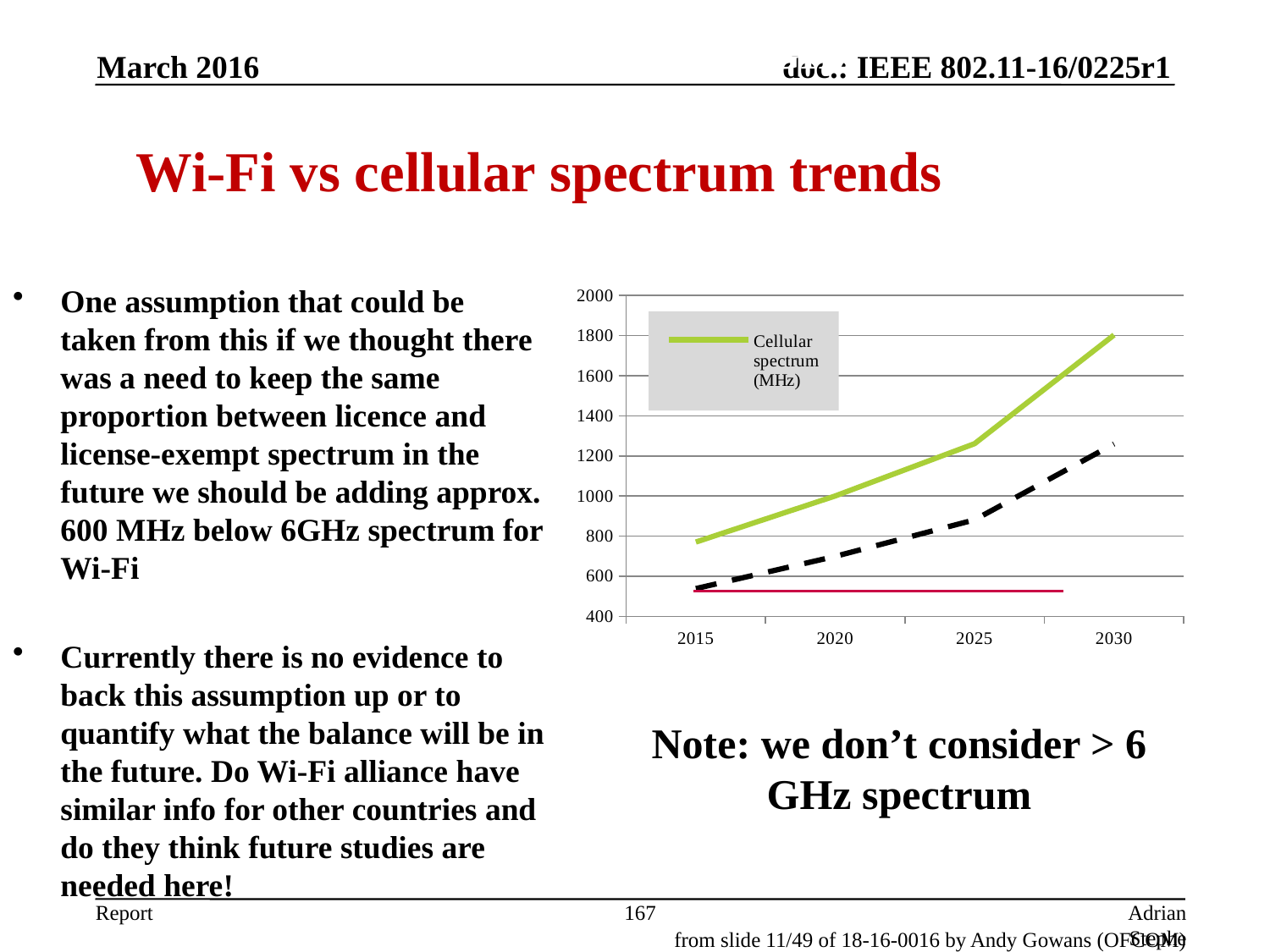
Is the Cellular spectrum (MHz) value for 2025 greater or less than 1200? greater What colour is the Cellular spectrum (MHz) line in the chart? green In 2025, which line is higher, the green Cellular spectrum line or the black dashed line? the green Cellular spectrum line What kind of chart is shown on the slide? line chart Is the Cellular spectrum (MHz) value for 2030 greater or less than 1600? greater Is the value of the black dashed line in 2015 greater or less than 600? less Which year has the higher Cellular spectrum (MHz) value, 2015 or 2030? 2030 How many years are marked on the x axis of the chart? 4 What series name is shown in the chart's legend? Cellular spectrum (MHz) Does the Cellular spectrum (MHz) line rise or fall from 2015 to 2030? rises